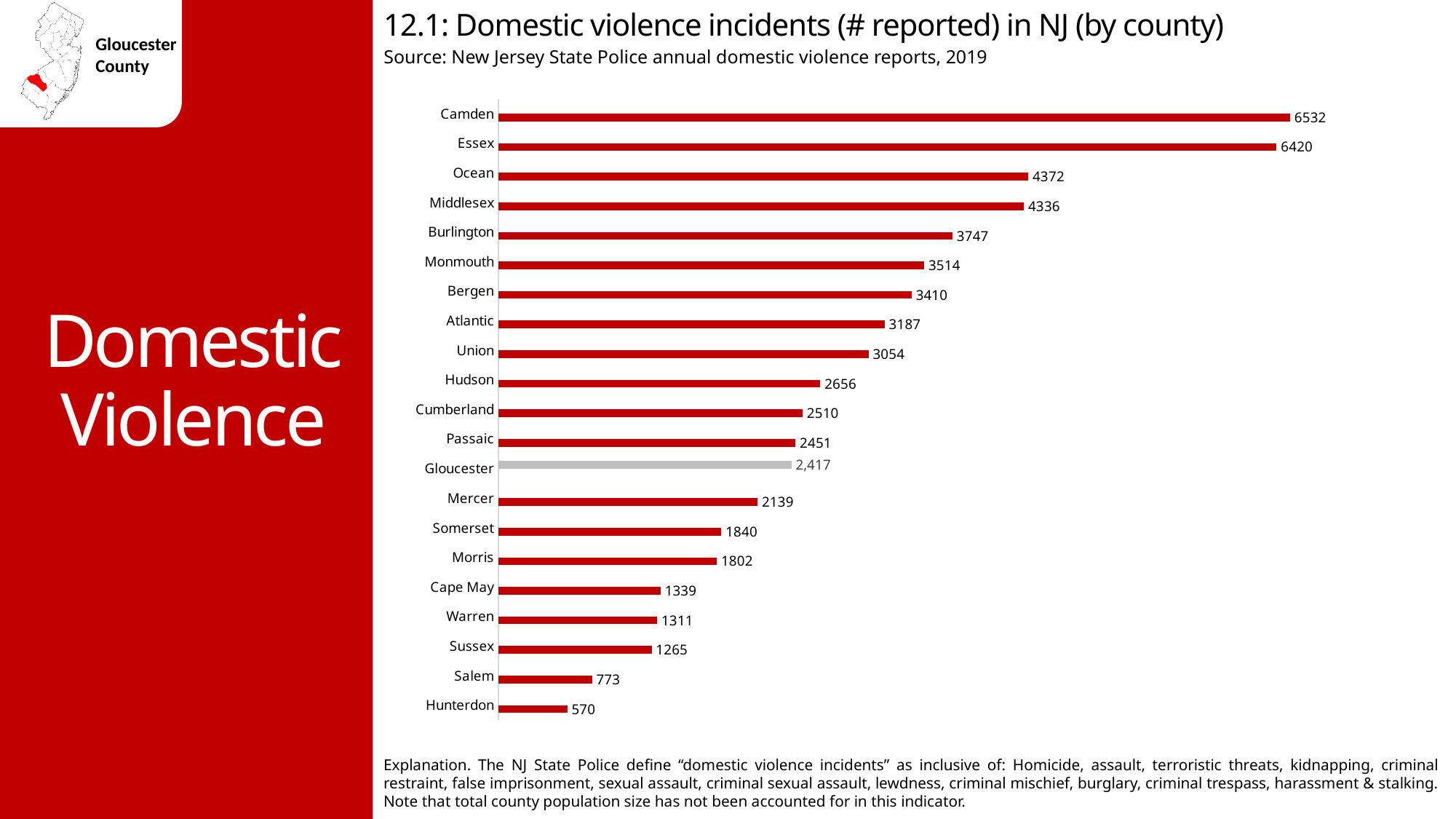
What is the number of reported domestic violence incidents for Gloucester County? 2,417 What is the number of reported domestic violence incidents for Hunterdon County? 570 Which county has more reported domestic violence incidents, Burlington or Monmouth? Burlington What is the difference in reported domestic violence incidents between Camden and Essex? 112 Which county's bar is shown in grey rather than red? Gloucester Which county has more reported domestic violence incidents, Salem or Sussex? Sussex What type of chart is used to show domestic violence incidents by county? Bar chart What is the difference in reported domestic violence incidents between Gloucester and Mercer? 278 What is the number of reported domestic violence incidents for Camden County? 6532 Which county has the lowest number of reported domestic violence incidents? Hunterdon Which county has the highest number of reported domestic violence incidents? Camden How many counties are shown in the chart? 21